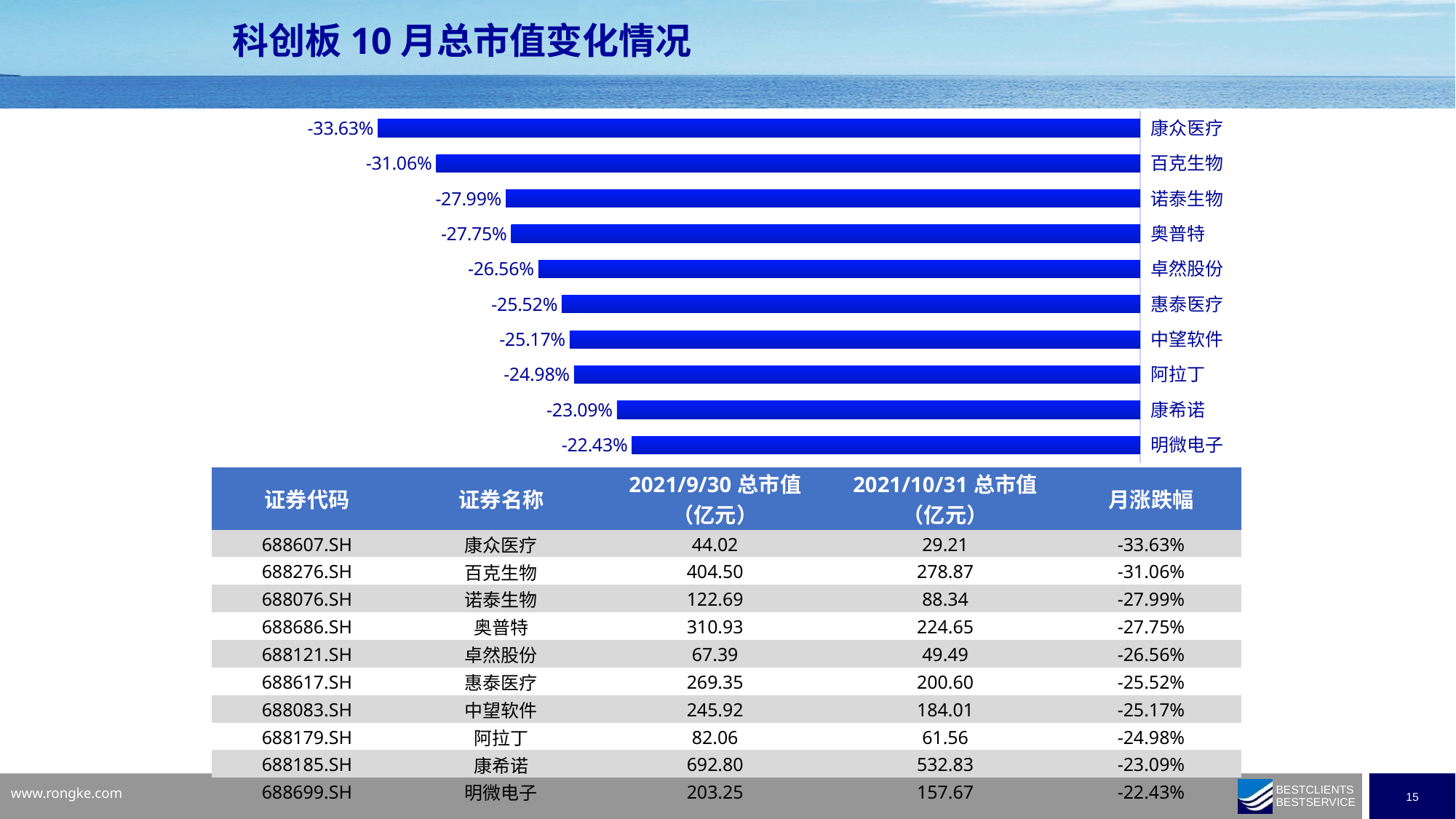
What is the difference in percentage points between the values for 百克生物 and 康希诺? 7.97 percentage points What is the value shown for 阿拉丁 in the bar chart? -24.98% What is the title of the slide containing the chart? 科创板 10 月总市值变化情况 What is the value shown for 康众医疗 in the bar chart? -33.63% Which has the larger (less negative) value, 卓然股份 or 惠泰医疗? 惠泰医疗 What kind of chart is shown on the slide? Bar chart What is the value shown for 奥普特 in the bar chart? -27.75% Which category has the lowest (most negative) value in the bar chart? 康众医疗 What is the value shown for 明微电子 in the bar chart? -22.43% Which category has the highest (least negative) value in the bar chart? 明微电子 What is the difference in percentage points between the values for 康众医疗 and 明微电子? 11.20 percentage points How many categories are plotted in the bar chart? 10